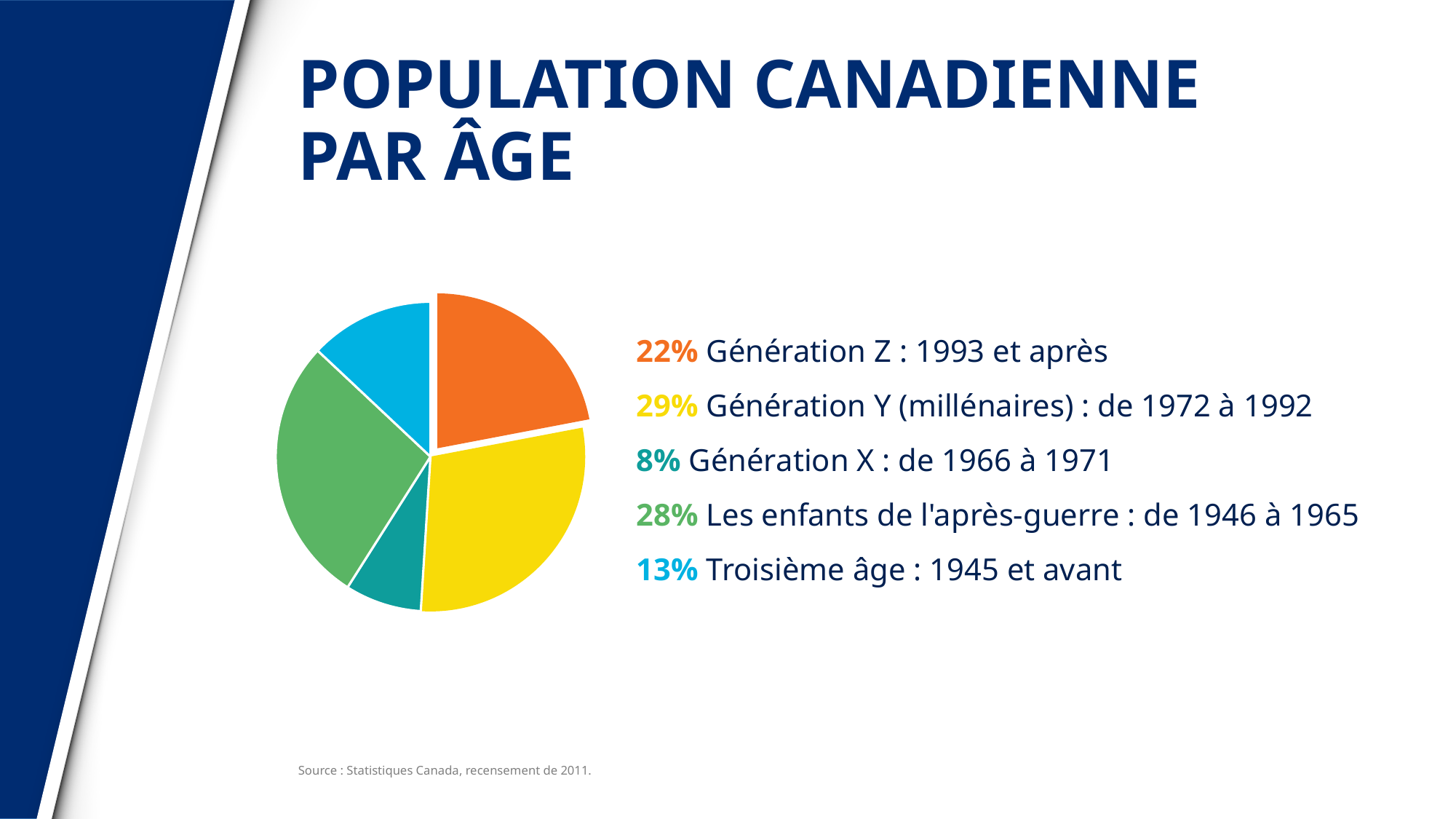
Which age group has the smallest share of the Canadian population? Génération X What share of the Canadian population is Les enfants de l'après-guerre (1946 à 1965)? 28% How many age groups are shown in the pie chart? 5 What share of the Canadian population is Génération X (1966 à 1971)? 8% What kind of chart is shown on the slide? Pie chart What share of the Canadian population is Troisième âge (1945 et avant)? 13% What colour represents Les enfants de l'après-guerre in the pie chart? Green Which group has a larger share, Génération Z or Troisième âge? Génération Z What share of the Canadian population is Génération Y (millénaires)? 29% What share of the Canadian population is Génération Z (1993 et après)? 22% Which age group has the largest share of the Canadian population? Génération Y (millénaires) What is the difference in percentage points between Génération Y and Génération X? 21